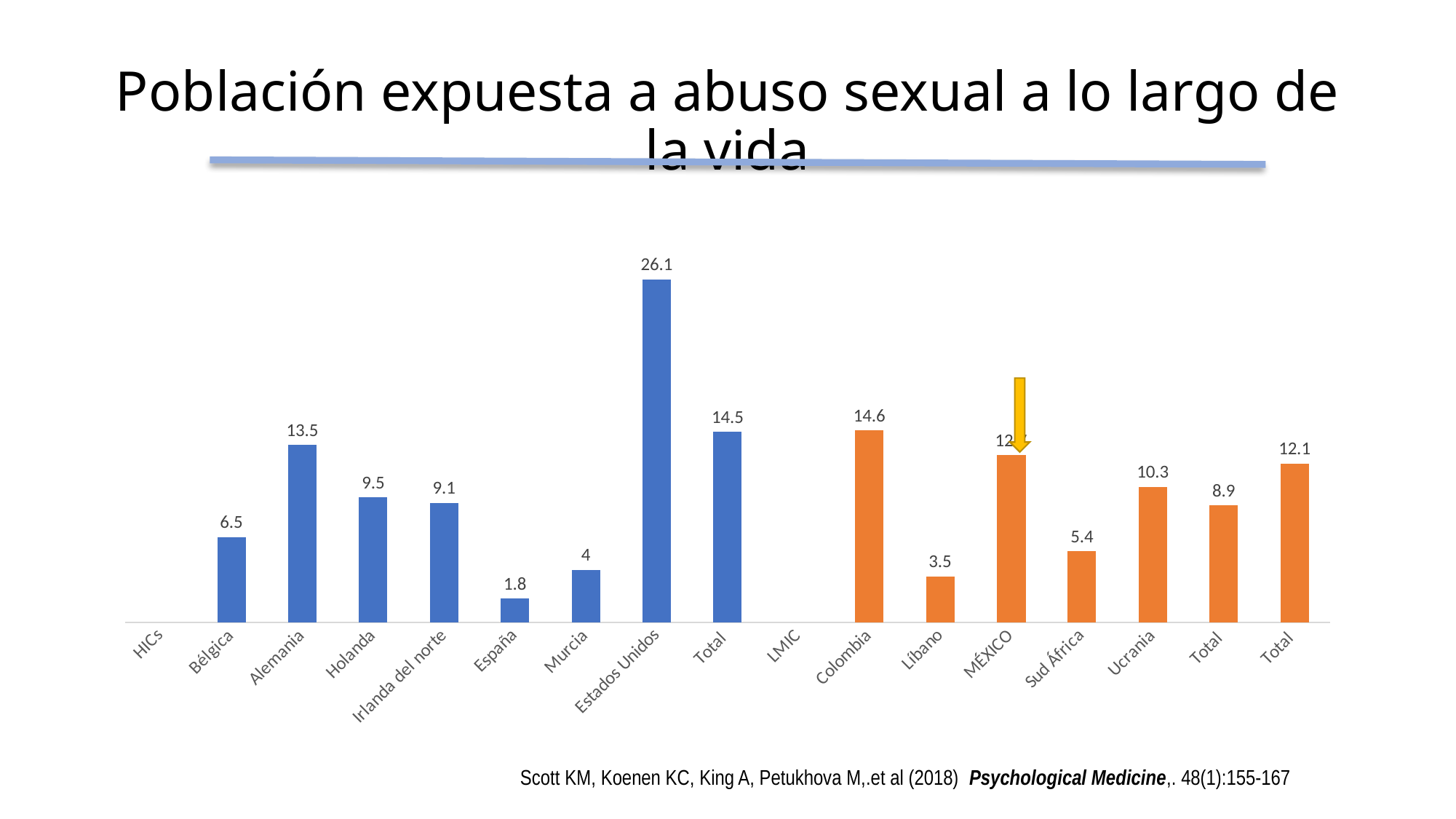
What is the value for Ucrania? 10.3 What is the difference between the values for Estados Unidos and Alemania? 12.6 What is the value for Colombia? 14.6 What kind of chart is shown on the slide? Bar chart What is the difference between the values for Colombia and Líbano? 11.1 What is the value for Alemania? 13.5 Which category does the yellow arrow point to? MÉXICO What is the value for Estados Unidos? 26.1 Which category has the highest value? Estados Unidos Which is larger, the value for Holanda or the value for Irlanda del norte? Holanda How many bars are plotted on the chart? 15 Which category has the lowest value? España